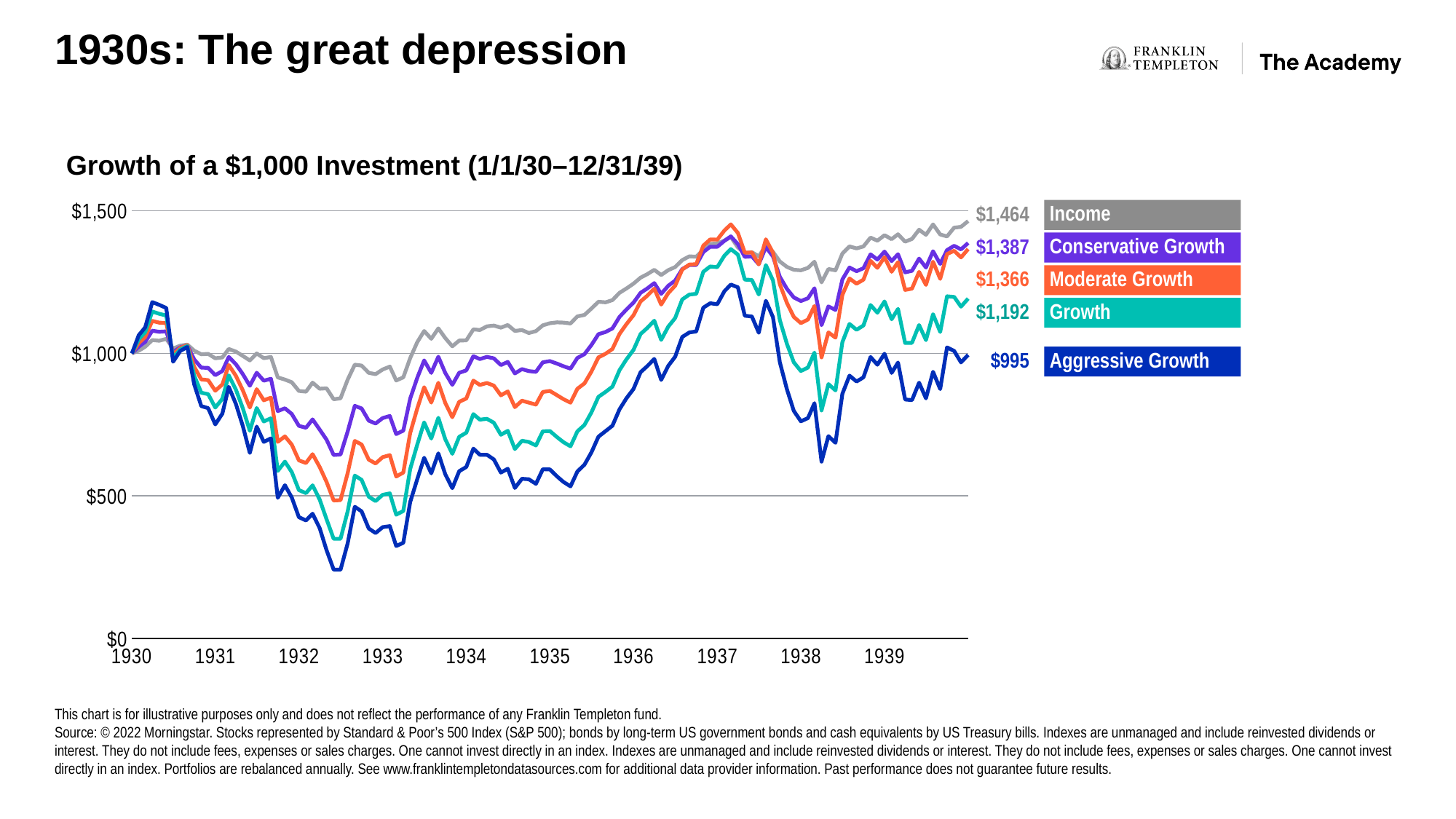
Which portfolio has the lowest ending value? Aggressive Growth What is the ending value of the Aggressive Growth portfolio? $995 Is the lowest point of the Aggressive Growth line in 1932 greater or less than $500? less Which portfolio has the highest ending value? Income What is the ending value of the Income portfolio at the end of 1939? $1,464 What is the difference between the ending values of the Conservative Growth and Growth portfolios? $195 How many portfolios are shown in the legend? 5 What is the difference between the ending values of the Income and Aggressive Growth portfolios? $469 What is the title of the chart? Growth of a $1,000 Investment (1/1/30–12/31/39) What is the ending value of the Moderate Growth portfolio? $1,366 What type of chart is shown on the slide? Line chart Which has a higher ending value, Conservative Growth or Moderate Growth? Conservative Growth